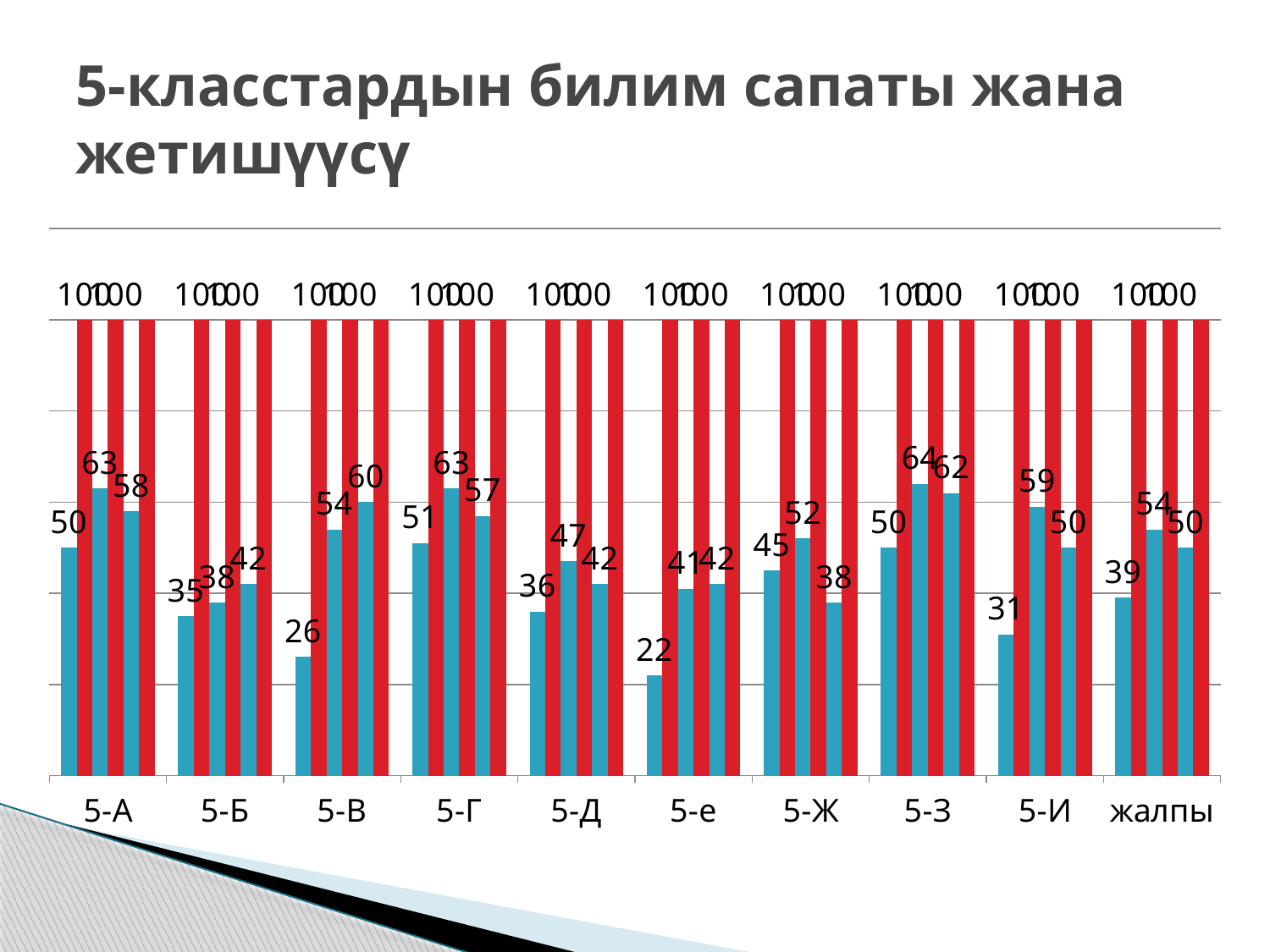
Which category has the highest value for its second blue bar? 5-З What kind of chart is shown on the slide? bar chart Which is larger: the first blue bar for 5-В or the first blue bar for 5-И? 5-И Which category has the lowest value for its first blue bar? 5-е How many categories are shown along the x axis of the chart? 10 What value is labelled on the first blue bar for 5-е? 22 What is the difference between the third blue bar for 5-В (60) and the third blue bar for 5-Б (42)? 18 What value is labelled on the third blue bar for жалпы? 50 What value is labelled on each of the red bars in the chart? 100 What is the title of the slide containing the chart? 5-класстардын билим сапаты жана жетишүүсү What value is labelled on the second blue bar for 5-З? 64 What is the difference between the second blue bar (63) and the first blue bar (50) for 5-А? 13